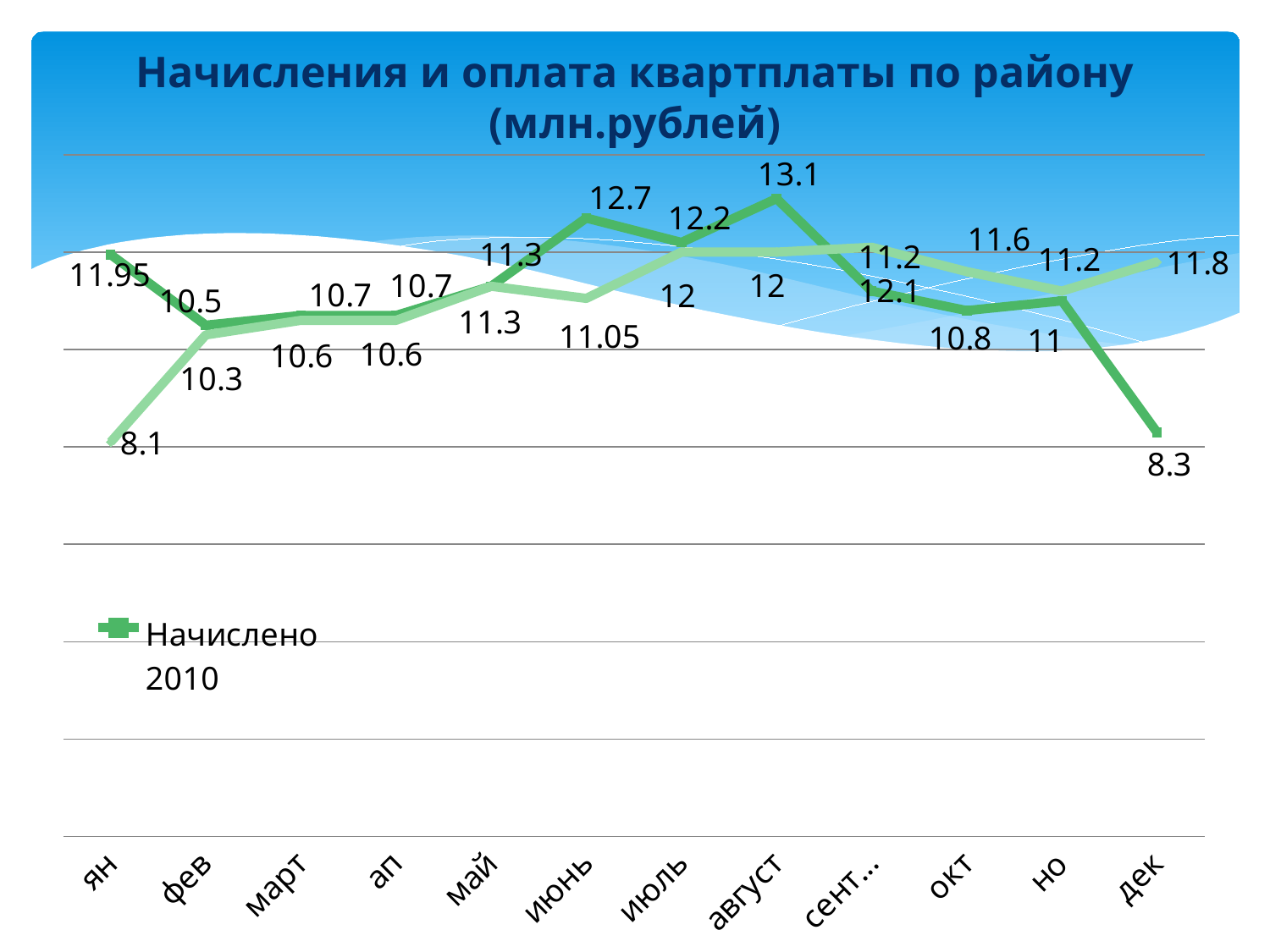
What is the value of Начислено 2010 for ян? 11.95 What is the title of the chart? Начисления и оплата квартплаты по району (млн.рублей) What is the difference between the Начислено 2010 values for август and дек? 4.8 What kind of chart is shown on the slide? line chart Which month has the larger Начислено 2010 value, июнь or июль? июнь In which month is Начислено 2010 lowest? дек How many months are plotted along the x axis? 12 What is the value of Начислено 2010 for июнь? 12.7 Does the Начислено 2010 line rise or fall from фев to июнь? rise What is the difference between the Начислено 2010 values for июнь and май? 1.4 What is the value of Начислено 2010 for август? 13.1 In which month is Начислено 2010 highest? август